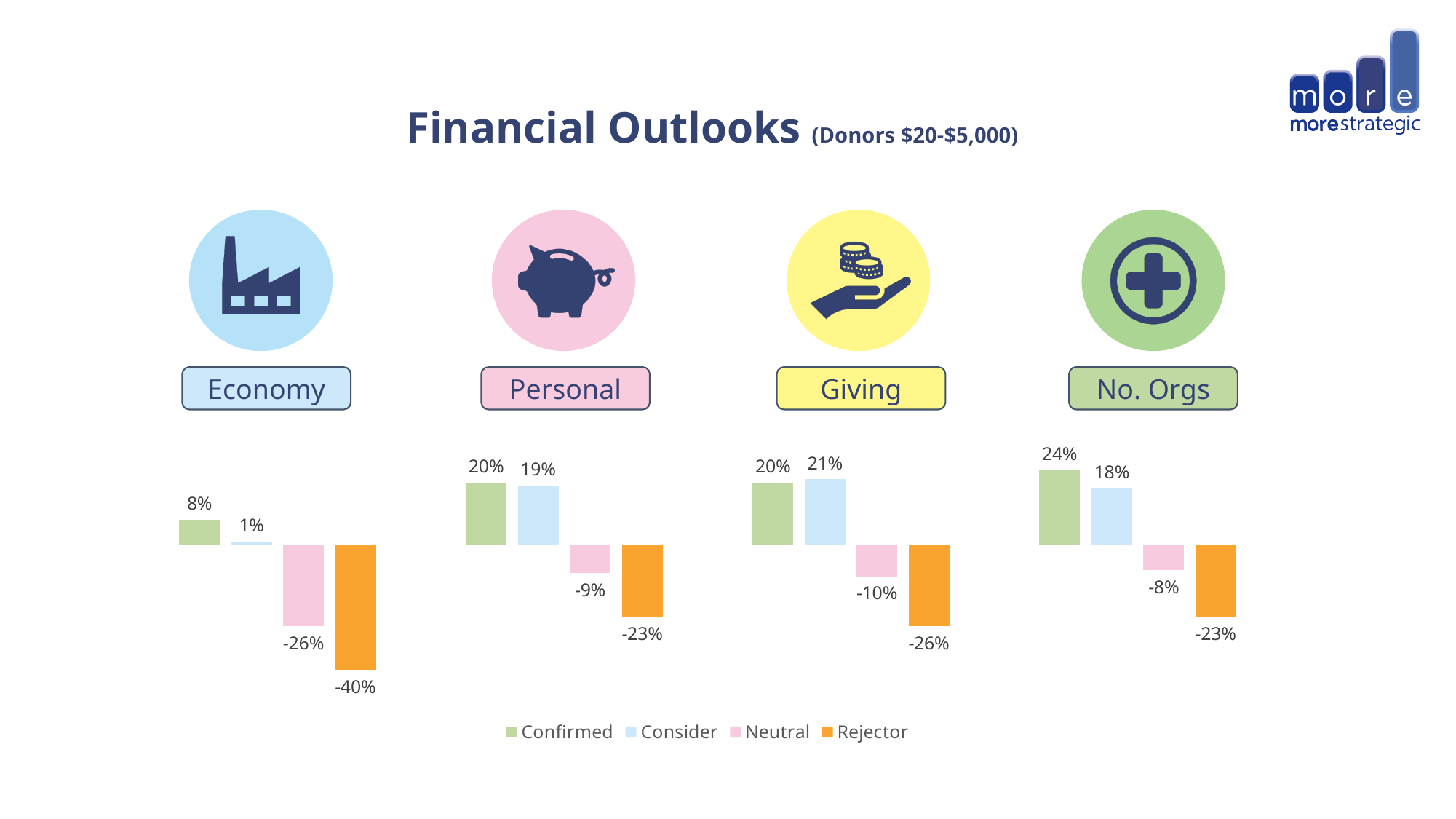
What is the value for Confirmed in the No. Orgs chart? 24% What is the value for Rejector in the Economy chart? -40% In the No. Orgs chart, which series has the highest value? Confirmed In the Economy chart, which series has the lowest value? Rejector What is the value for Neutral in the Giving chart? -10% What colour represents the Rejector series in the legend? Orange What is the difference between the Confirmed and Consider values in the Economy chart? 7% In the Giving chart, which is larger, the Confirmed value or the Consider value? Consider What is the value for Consider in the Personal chart? 19% How many series does the legend list? 4 How many outlook categories are shown on the slide? 4 What kind of chart is used for each of the four outlooks? Bar chart